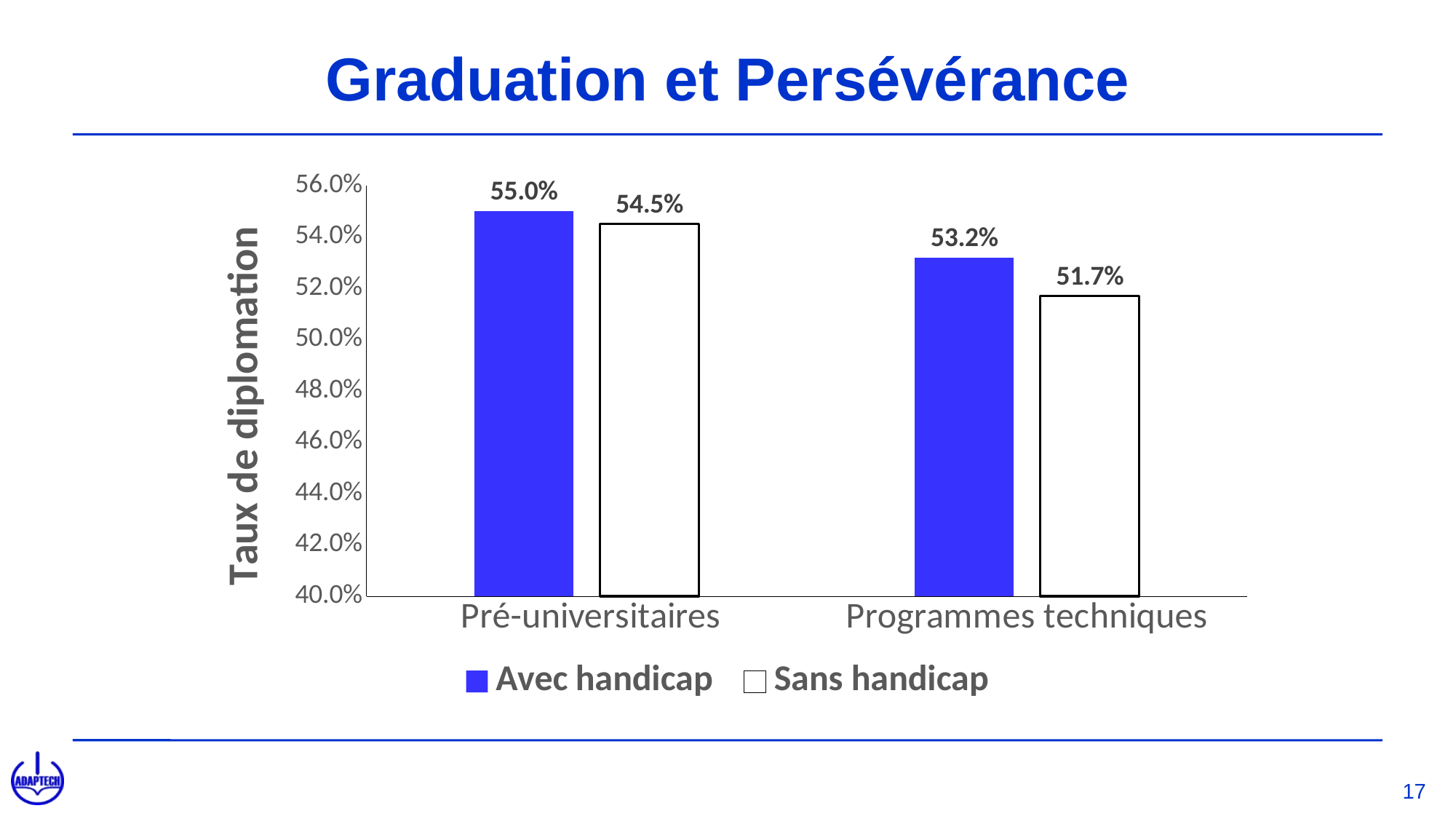
Which bar has the highest value on the chart? Avec handicap, Pré-universitaires How many series does the legend list? 2 What is the value for Sans handicap in Pré-universitaires? 54.5% What is the value for Sans handicap in Programmes techniques? 51.7% Which bar has the lowest value on the chart? Sans handicap, Programmes techniques What is the value for Avec handicap in Pré-universitaires? 55.0% How many categories are shown on the x axis? 2 What kind of chart is shown on the slide? Bar chart What is the difference between the Avec handicap values for Pré-universitaires and Programmes techniques? 1.8% What is the value for Avec handicap in Programmes techniques? 53.2% Which is larger in Pré-universitaires: Avec handicap or Sans handicap? Avec handicap What is the difference between Avec handicap and Sans handicap in Programmes techniques? 1.5%